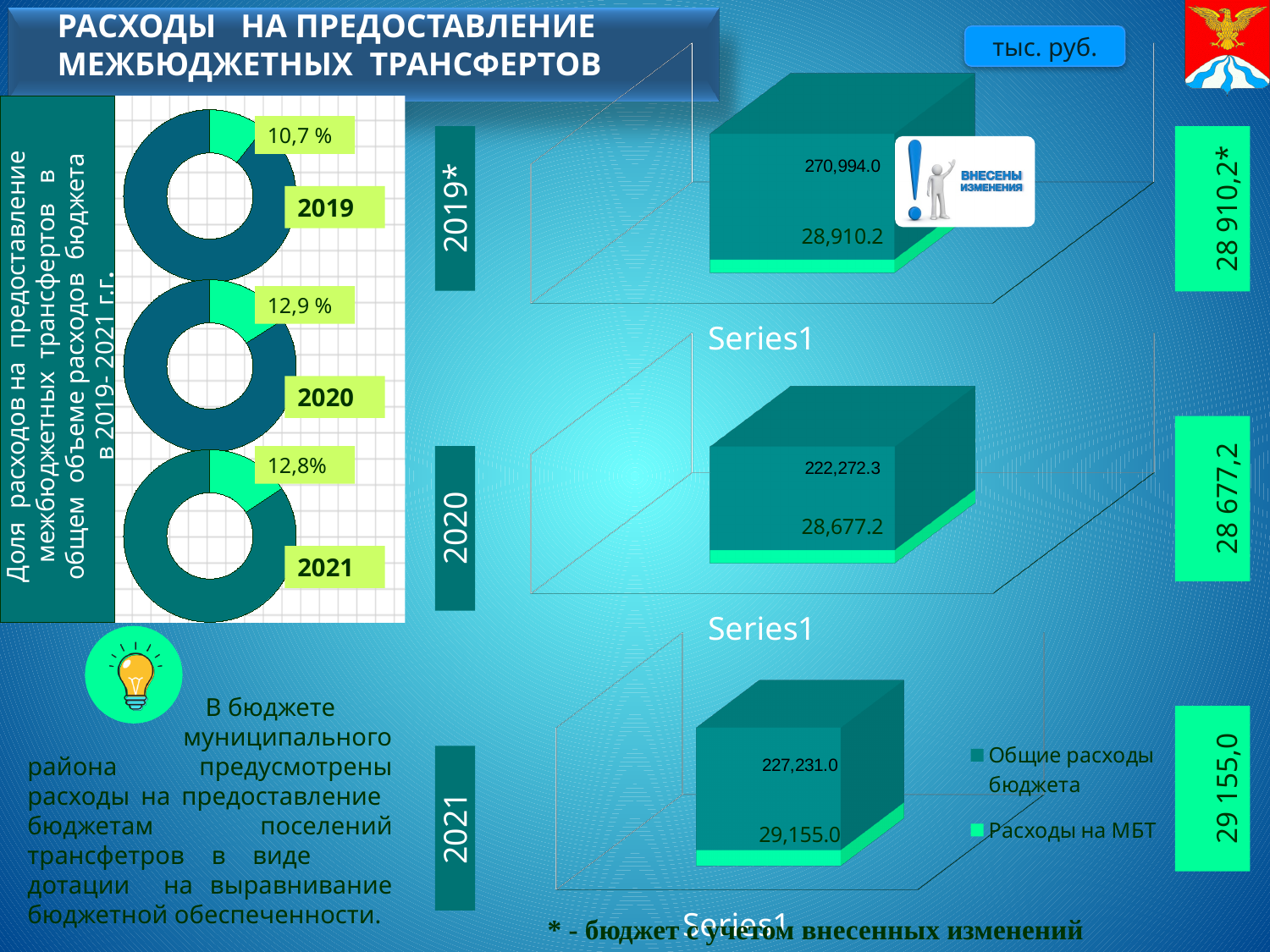
Across the three bar charts, which year has the highest total budget expenses value? 2019* In the donut chart for 2020, what share is shown for intergovernmental transfers? 12,9 % What unit is indicated for the values in the bar charts? тыс. руб. In the 2019* bar chart, what value is printed for the total budget expenses (Общие расходы бюджета)? 270,994.0 Across the three bar charts, which year has the lowest expenses on MBT value? 2020 What is the difference between the total budget expenses in the 2019* chart and in the 2020 chart? 48,721.7 In the donut chart for 2019, what share of budget expenses goes to intergovernmental transfers? 10,7 % How many series does the legend of the bar charts list? 2 In the 2020 bar chart, what value is printed for the total budget expenses? 222,272.3 In the 2019* bar chart, what value is printed for expenses on MBT (Расходы на МБТ)? 28,910.2 In the 2021 bar chart, what value is printed for the total budget expenses? 227,231.0 In the 2021 bar chart, what value is printed for expenses on MBT? 29,155.0